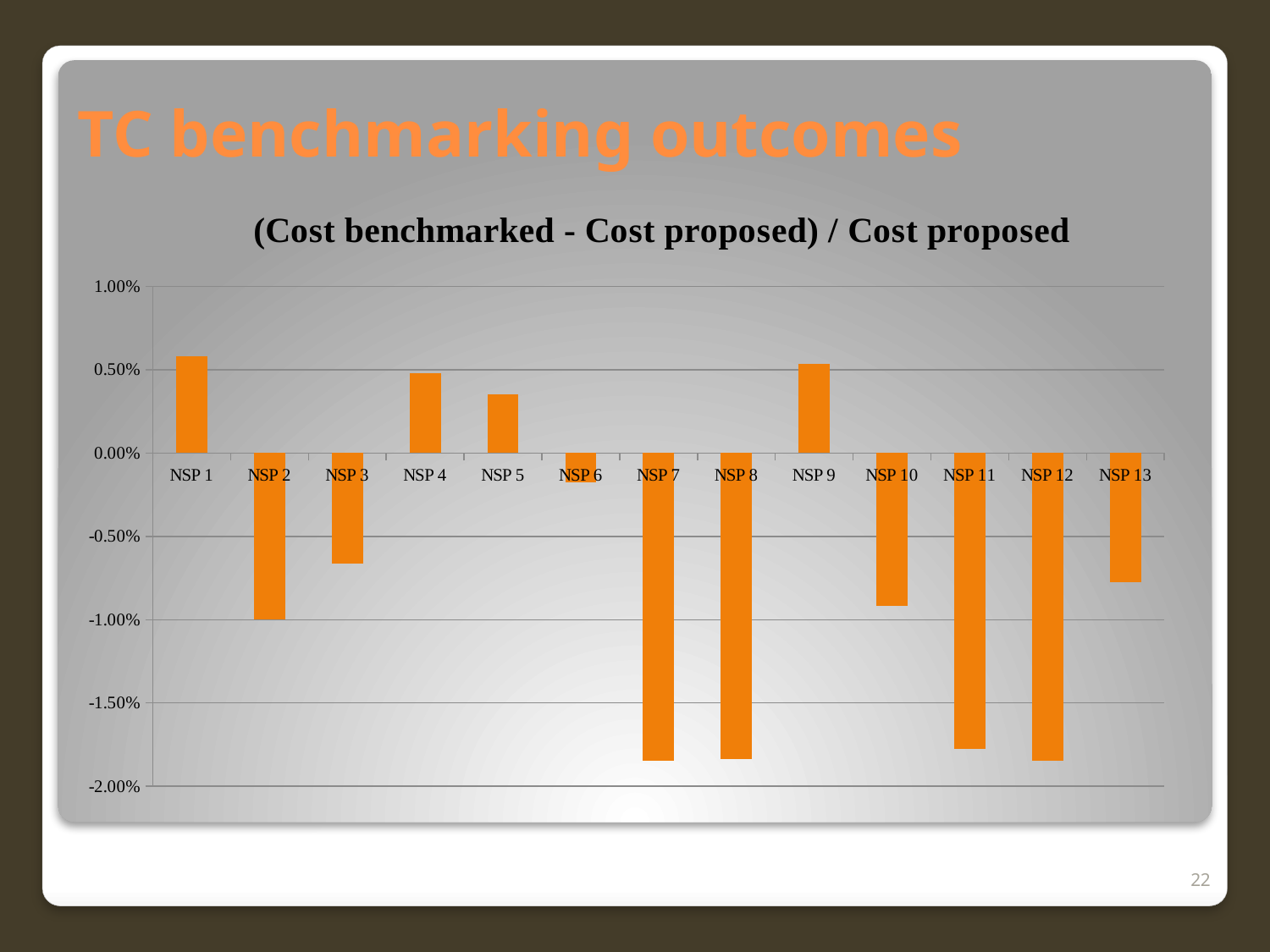
Is the value for NSP 13 greater or less than -1.00%? greater Is the value for NSP 3 greater or less than -0.50%? less Is the value for NSP 1 greater or less than 0.50%? greater What is the title of the chart? (Cost benchmarked - Cost proposed) / Cost proposed How many of the NSP bars have a positive value? 4 What type of chart is shown on the slide? bar chart Which has the larger value, NSP 4 or NSP 5? NSP 4 Which has the larger value, NSP 2 or NSP 3? NSP 3 How many NSP categories are plotted on the chart? 13